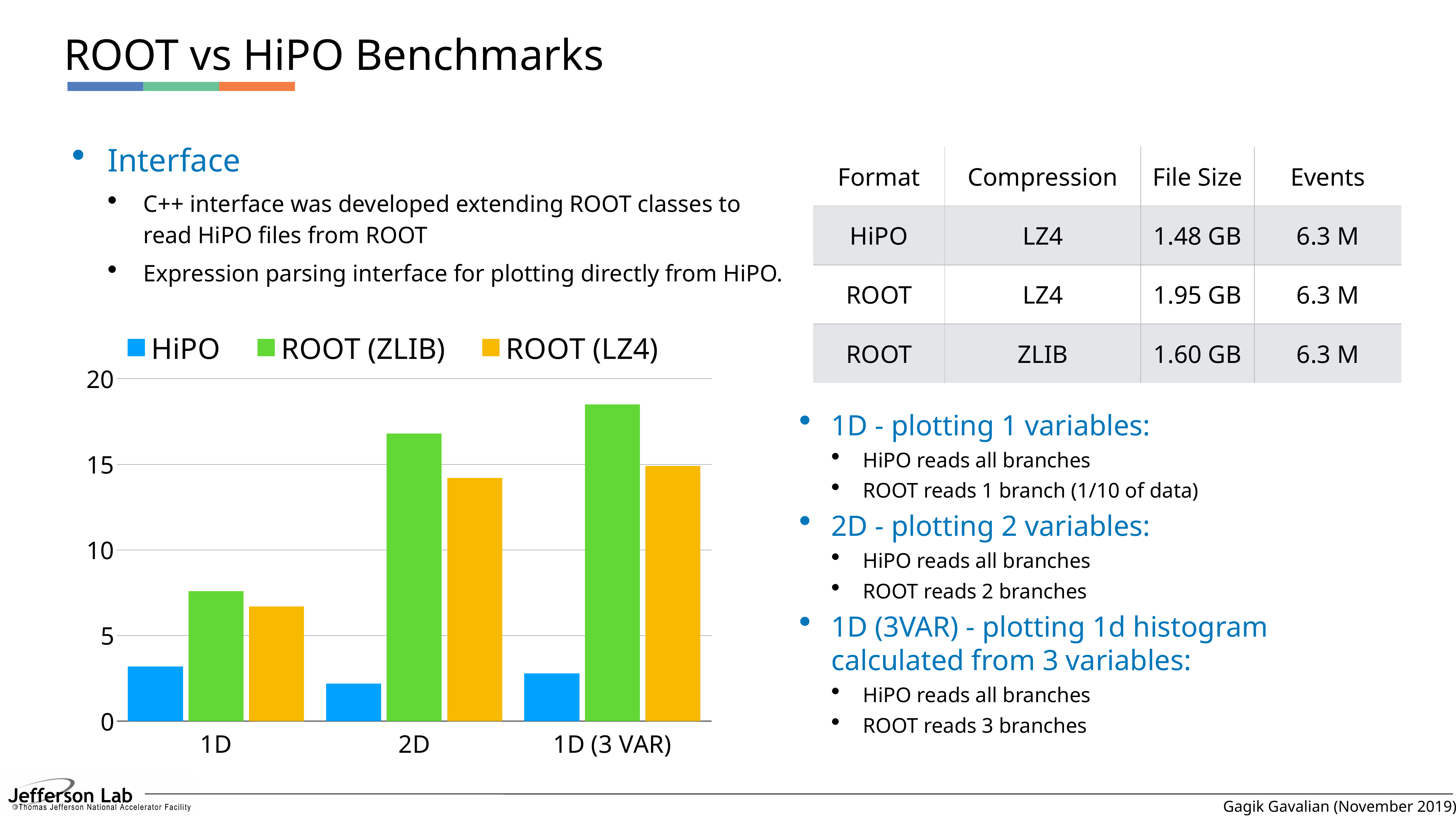
Is the value for HiPO in the 1D category greater or less than 5? less What kind of chart is shown on the slide? bar chart Which series has the lowest bar in the 2D category? HiPO What colour represents the HiPO series in the chart's legend? blue Which series has the highest bar in the 1D (3 VAR) category? ROOT (ZLIB) Is the value for ROOT (ZLIB) in the 1D (3 VAR) category greater or less than 15? greater How many categories are shown on the x axis of the chart? 3 How many series does the chart's legend list? 3 Is the value for ROOT (LZ4) in the 1D category greater or less than 5? greater In the 2D category, which is larger: ROOT (ZLIB) or ROOT (LZ4)? ROOT (ZLIB) Do the ROOT (ZLIB) values rise or fall from 1D to 1D (3 VAR) along the x axis? rise